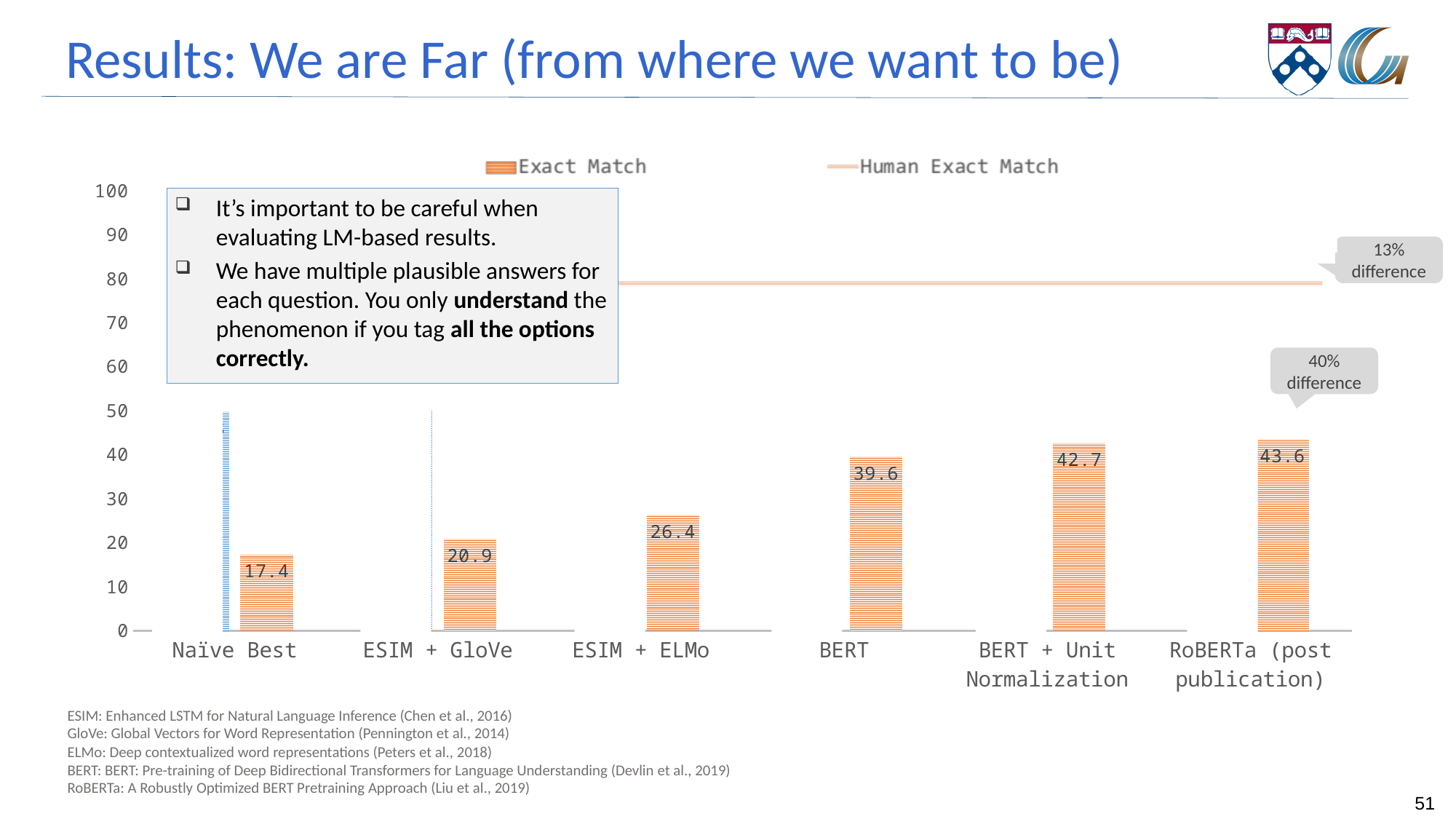
How many categories are shown on the x axis? 6 Which category has the highest Exact Match value? RoBERTa (post publication) Is the Human Exact Match line greater or less than 70? greater What is the Exact Match value for RoBERTa (post publication)? 43.6 What is the Exact Match value for Naïve Best? 17.4 How many series does the legend list? 2 What is the Exact Match value for BERT? 39.6 Which category has the lowest Exact Match value? Naïve Best What is the difference in Exact Match between BERT + Unit Normalization and BERT? 3.1 What kind of chart is shown on the slide? bar chart Do the Exact Match values rise or fall from left to right along the x axis? rise Which has a higher Exact Match value, ESIM + ELMo or ESIM + GloVe? ESIM + ELMo